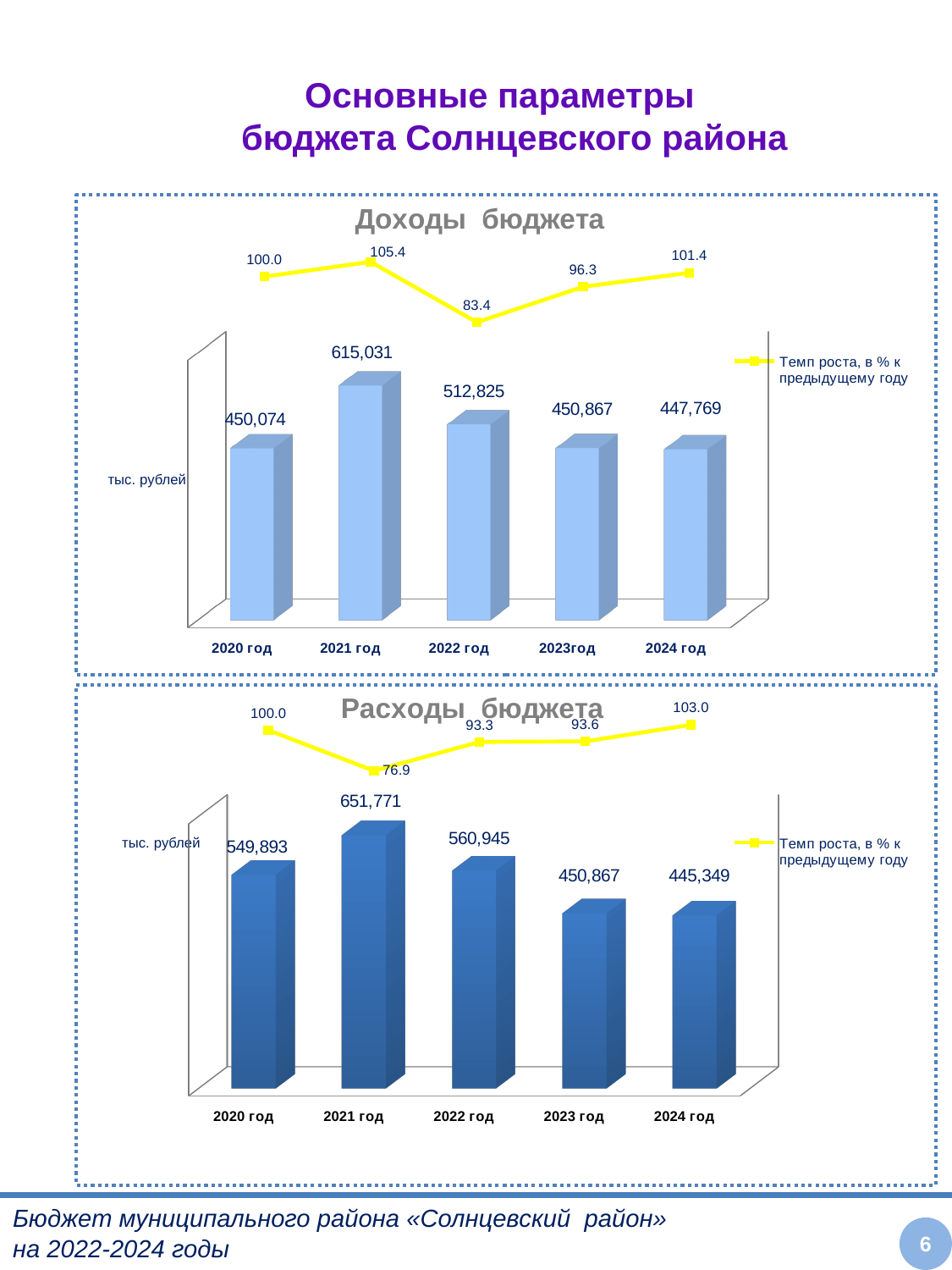
In the 'Расходы бюджета' chart, which is larger: the value for 2020 год or the value for 2022 год? 2022 год In the 'Расходы бюджета' chart, which year has the lowest bar value? 2024 год In the 'Расходы бюджета' chart, what is the growth rate (Темп роста) value for 2024 год? 103.0 In the 'Расходы бюджета' chart, what is the value for 2022 год? 560,945 How many years are shown on the x axis of the 'Доходы бюджета' chart? 5 In the 'Расходы бюджета' chart, what is the difference between the values for 2021 год and 2024 год? 206,422 In the 'Доходы бюджета' chart, what is the difference between the values for 2021 год and 2020 год? 164,957 In the 'Доходы бюджета' chart, which year has the highest bar value? 2021 год What kind of chart is used for the bars in the 'Расходы бюджета' chart? Bar chart In the 'Доходы бюджета' chart, what is the growth rate (Темп роста) value for 2022 год? 83.4 In the 'Доходы бюджета' chart, what is the value for 2021 год? 615,031 In the 'Доходы бюджета' chart, which year has the lowest growth rate (Темп роста) value? 2022 год